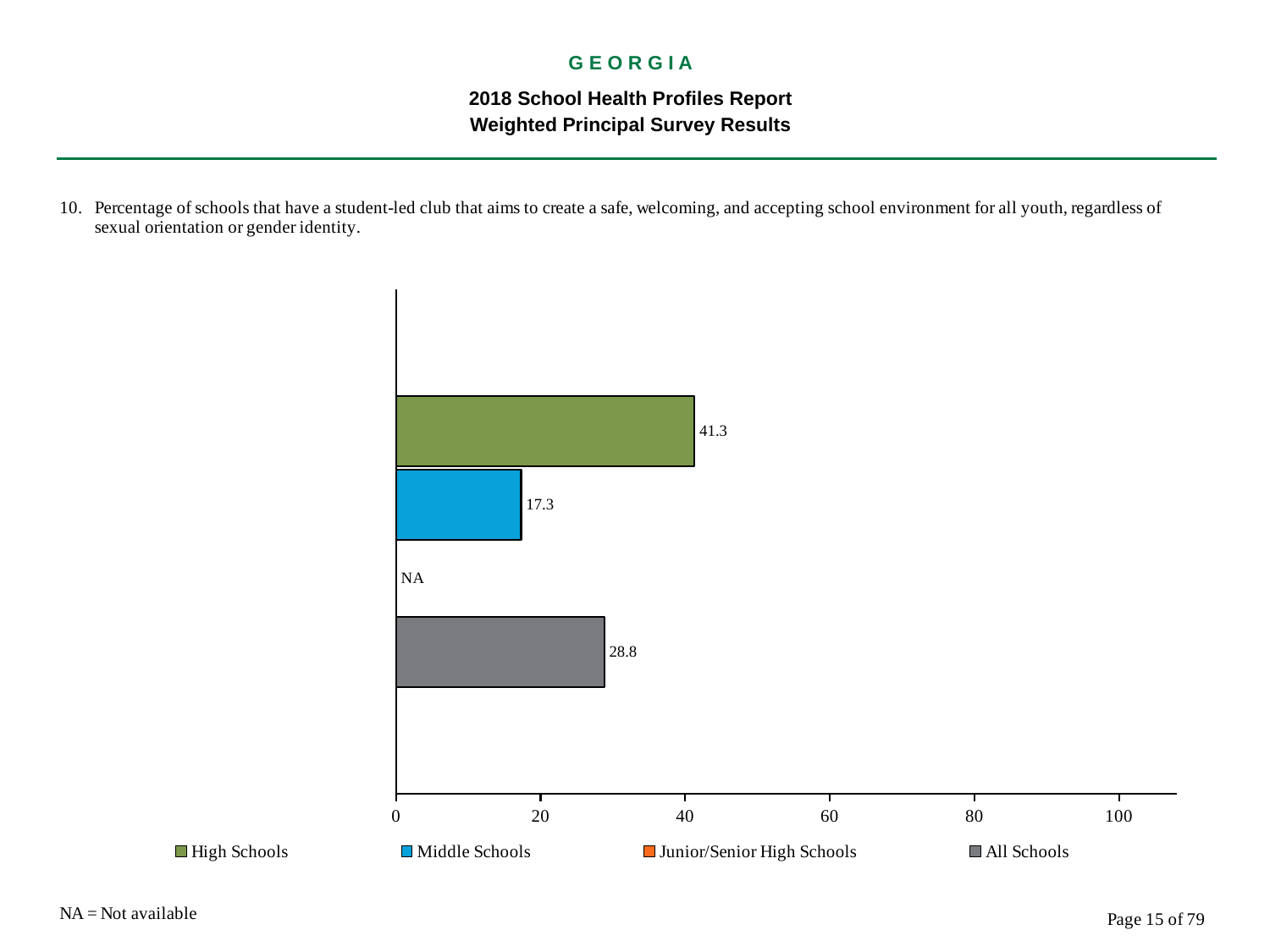
What is the difference between the High Schools value and the All Schools value? 12.5 What is the value for High Schools? 41.3 What is the value for All Schools? 28.8 Which school type has the highest value? High Schools Which is larger, the value for Middle Schools or the value for All Schools? All Schools How many series does the legend list? 4 What is shown for Junior/Senior High Schools? NA What kind of chart is shown on the slide? bar chart Is the value for High Schools greater or less than 40? greater What is the value for Middle Schools? 17.3 What is the difference between the High Schools value and the Middle Schools value? 24.0 Which school type with a plotted value has the lowest value? Middle Schools